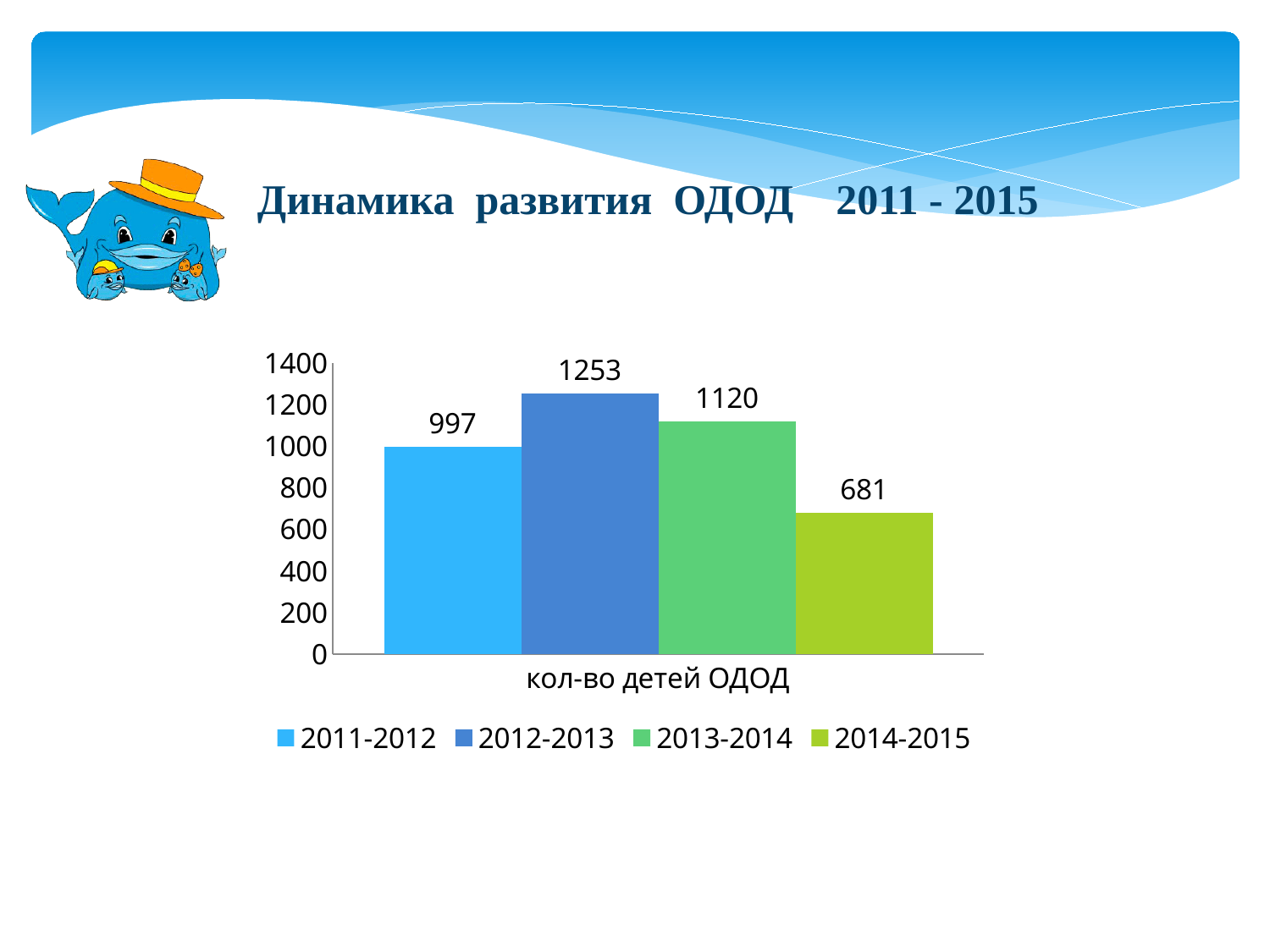
Which series has the lowest value? 2014-2015 Which series has the highest value? 2012-2013 What is the value for 2011-2012? 997 What is the difference between the values for 2012-2013 and 2014-2015? 572 How many series does the legend list? 4 What is the value for 2014-2015? 681 What is the category label shown on the x axis? кол-во детей ОДОД What is the value for 2013-2014? 1120 What is the difference between the values for 2013-2014 and 2011-2012? 123 Which is larger, the value for 2011-2012 or the value for 2013-2014? 2013-2014 What is the value for 2012-2013? 1253 What kind of chart is shown on the slide? bar chart